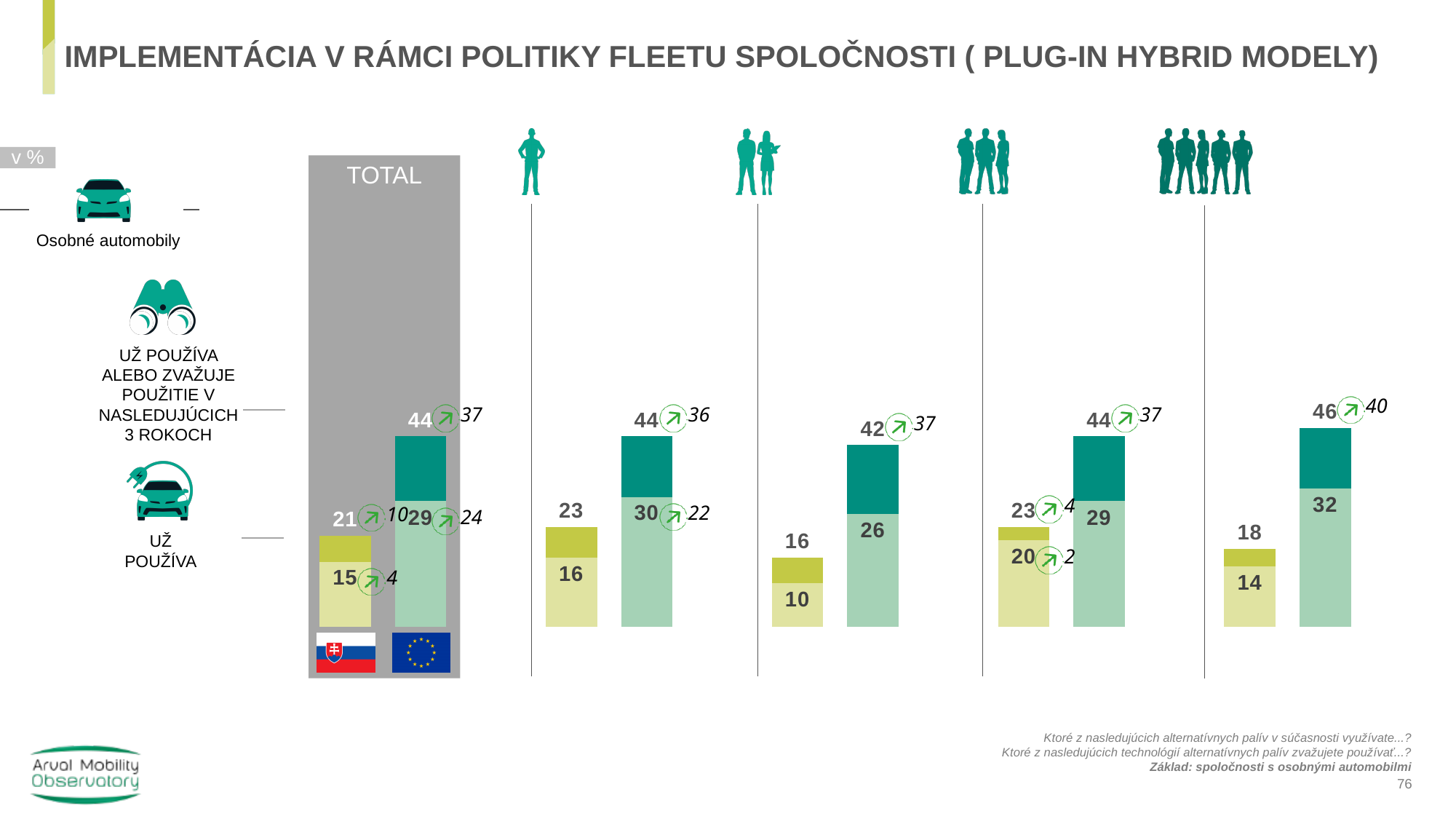
In the TOTAL block, what is the EU value for "UŽ POUŽÍVA ALEBO ZVAŽUJE POUŽITIE V NASLEDUJÚCICH 3 ROKOCH" (the top label of the green bar)? 44 Across all groups, which group has the lowest Slovakia value for "UŽ POUŽÍVA"? The second group to the right of TOTAL (10) What kind of chart is shown on the slide? Bar chart In the TOTAL block, what is the difference between the EU and Slovakia values for "UŽ POUŽÍVA ALEBO ZVAŽUJE" (44 vs 21)? 23 In what unit are the values on the chart expressed, according to the label at the top left? % In the rightmost group of bars, what is the EU value for "UŽ POUŽÍVA"? 32 Across all groups, which group has the highest EU value for "UŽ POUŽÍVA ALEBO ZVAŽUJE"? The rightmost group (46) In the TOTAL block, which is larger for "UŽ POUŽÍVA": the Slovakia bar or the EU bar? EU In the TOTAL block, what is the Slovakia value for "UŽ POUŽÍVA ALEBO ZVAŽUJE POUŽITIE V NASLEDUJÚCICH 3 ROKOCH"? 21 In the TOTAL block, what is the Slovakia value for "UŽ POUŽÍVA" (the lighter bottom segment of the yellow bar)? 15 In the rightmost group of bars, what is the difference between the EU and Slovakia values for "UŽ POUŽÍVA ALEBO ZVAŽUJE" (46 vs 18)? 28 In the TOTAL block, what is the EU value for "UŽ POUŽÍVA"? 29